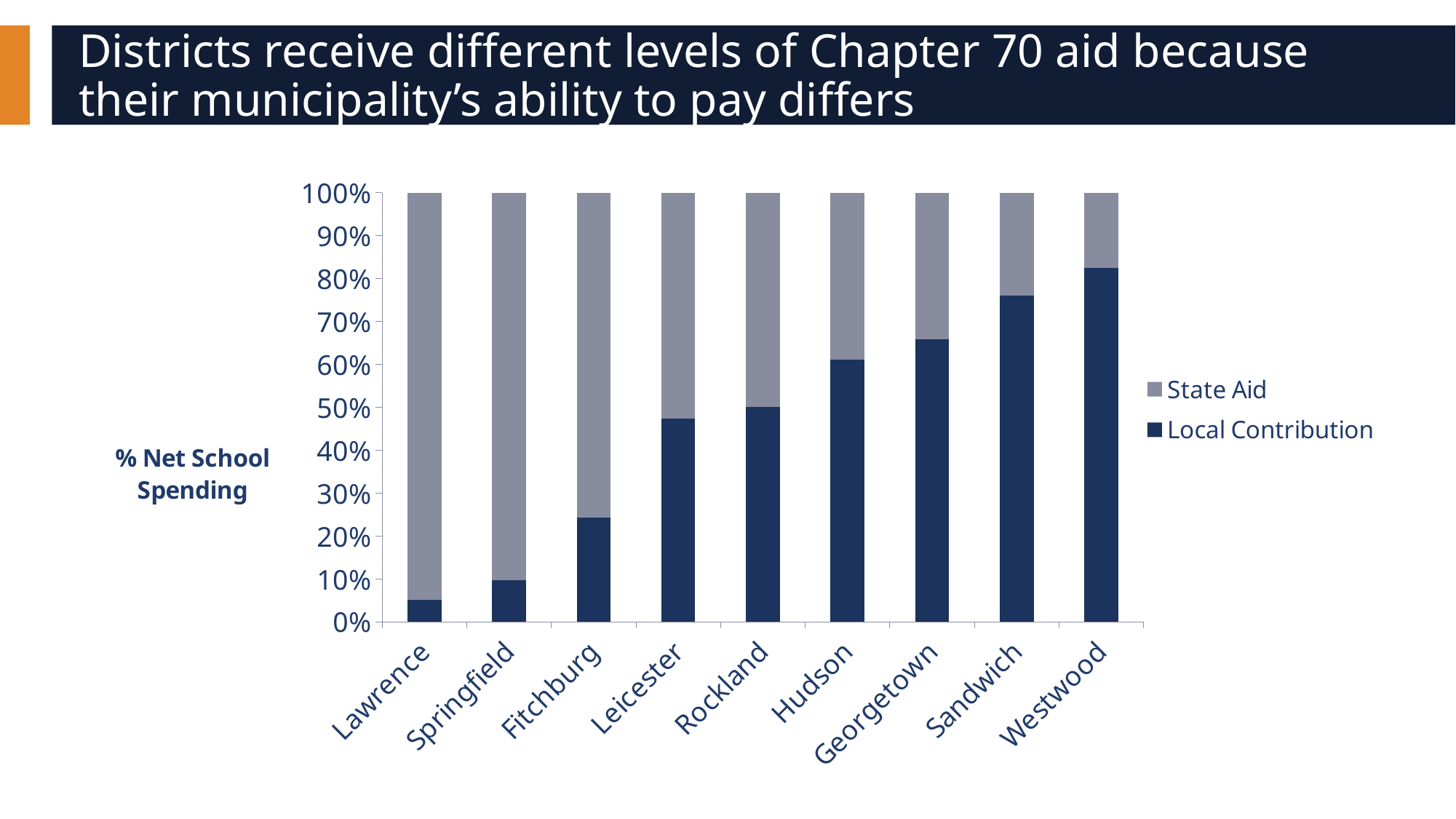
Moving from Lawrence on the left to Westwood on the right, does the Local Contribution share rise or fall? Rises What kind of chart is shown on the slide? Stacked bar chart Is the Local Contribution for Sandwich greater or less than 70%? greater Is the Local Contribution for Lawrence greater or less than 10%? less Is the Local Contribution for Fitchburg greater or less than 30%? less Which district has the lowest Local Contribution share of net school spending? Lawrence What is the label on the vertical axis of the chart? % Net School Spending Which district receives the largest State Aid share of net school spending? Lawrence Which district has a larger Local Contribution share, Hudson or Springfield? Hudson How many districts are shown along the x axis of the chart? 9 Which district has the highest Local Contribution share of net school spending? Westwood How many series does the chart's legend list? 2